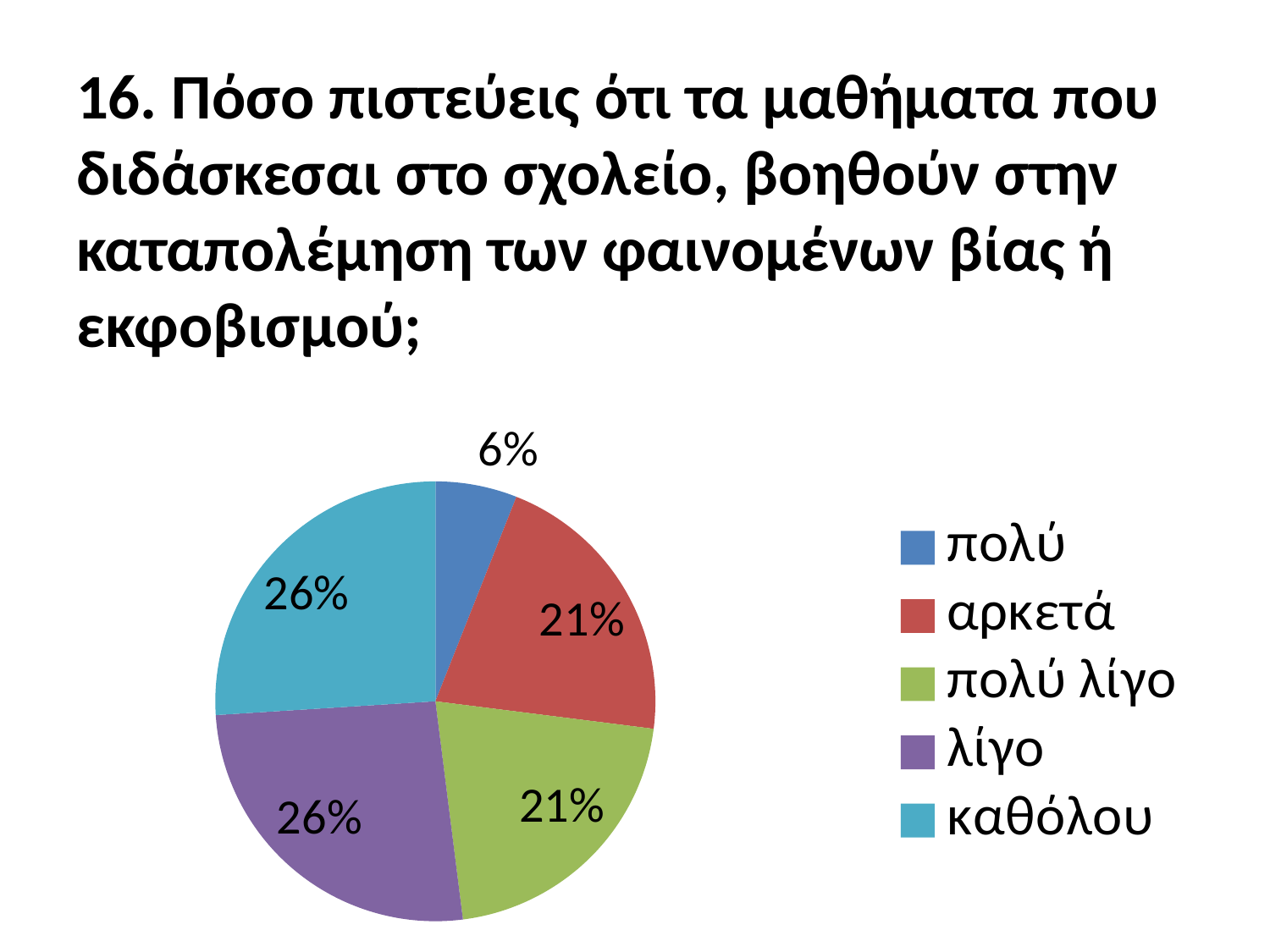
What share of the pie does the slice for πολύ represent? 6% What share of the pie does the slice for λίγο represent? 26% Which category has the smallest slice of the pie? πολύ What share of the pie does the slice for αρκετά represent? 21% Which is larger, the slice for αρκετά or the slice for πολύ? αρκετά How many slices does the pie chart have? 5 Which is larger, the slice for καθόλου or the slice for πολύ λίγο? καθόλου What kind of chart is shown on the slide? pie chart What is the difference in percentage points between the slice for καθόλου and the slice for πολύ? 20 How many entries does the legend list? 5